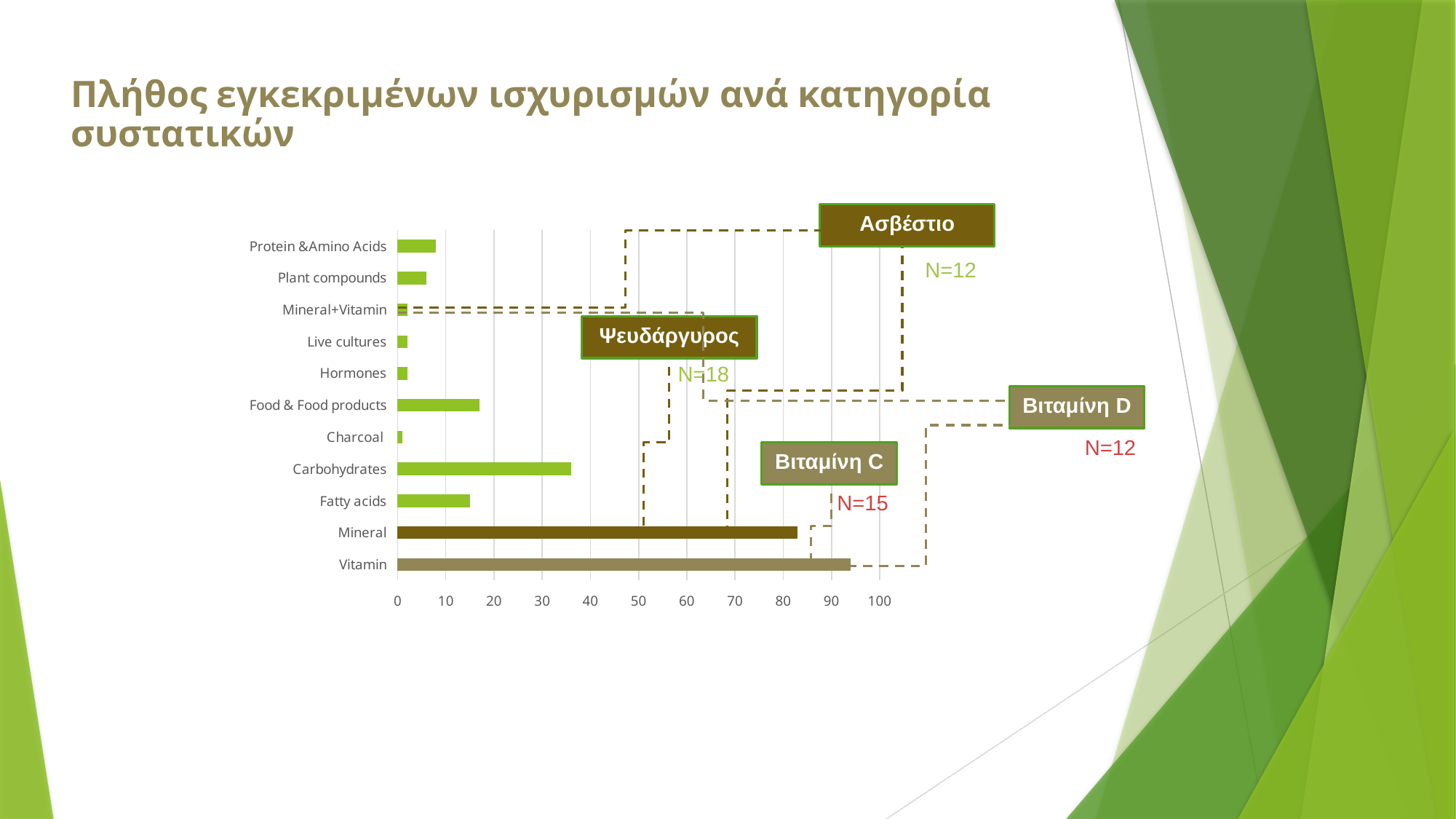
What N value is shown next to the Ψευδάργυρος annotation box? N=18 How many categories are plotted on the chart? 11 Is the value for Mineral greater or less than 80? greater Which category has the highest value on the chart? Vitamin Is the value for Protein & Amino Acids greater or less than 10? less Is the value for Vitamin greater or less than 90? greater Which is larger, the value for Carbohydrates or the value for Fatty acids? Carbohydrates What is the title of the slide containing the chart? Πλήθος εγκεκριμένων ισχυρισμών ανά κατηγορία συστατικών Which is larger, the value for Mineral or the value for Vitamin? Vitamin What kind of chart is shown on the slide? Bar chart